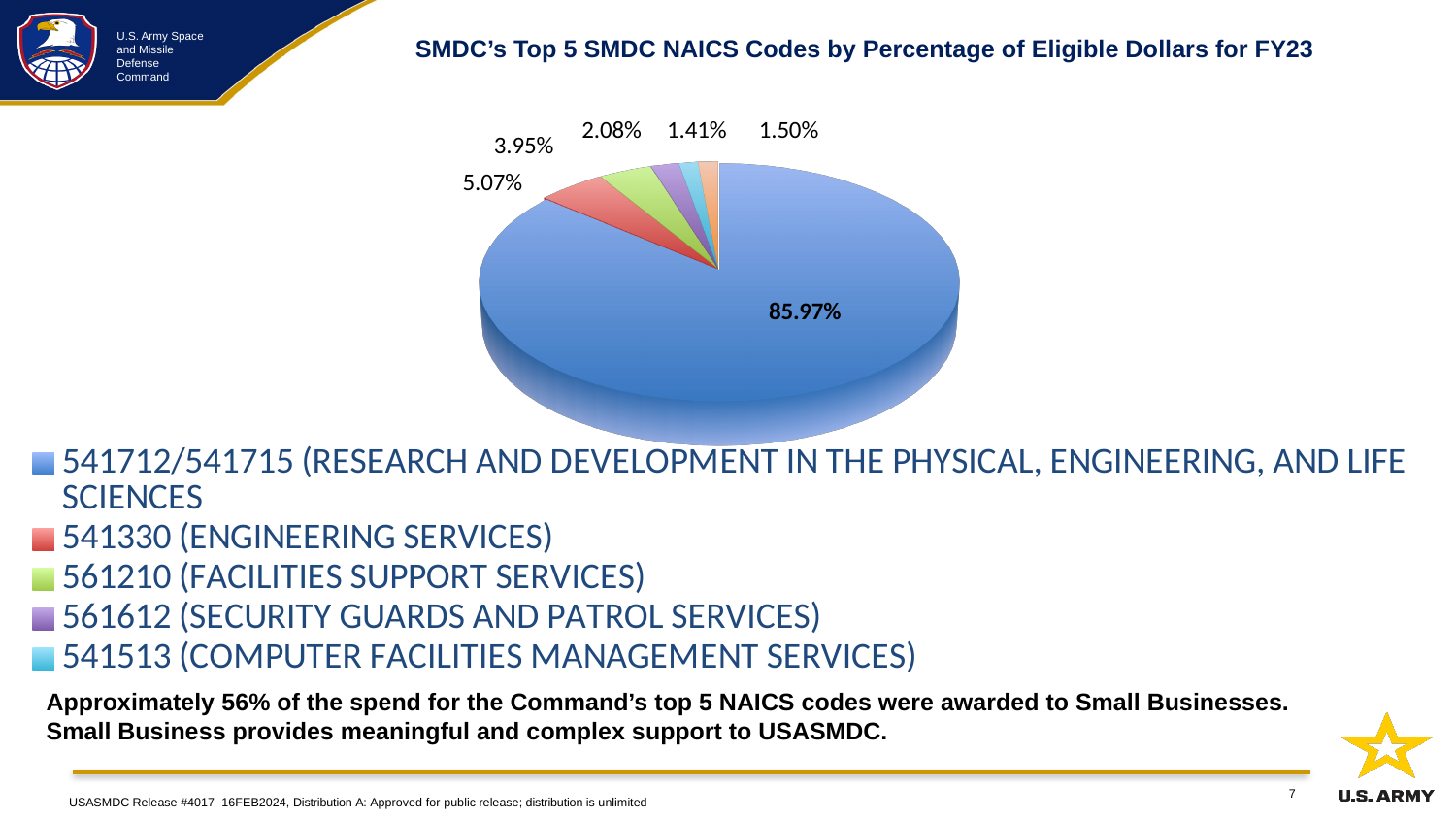
What percentage is shown for 561612 (Security Guards and Patrol Services)? 2.08% Which NAICS code category has the largest share of the pie? 541712/541715 (Research and Development in the Physical, Engineering, and Life Sciences) What is the difference in percentage points between the 541712/541715 slice and the 541330 (Engineering Services) slice? 80.90% What percentage is shown for 561210 (Facilities Support Services)? 3.95% Which of the legend categories has the smallest share of the pie? 541513 (Computer Facilities Management Services) What percentage is shown for 541513 (Computer Facilities Management Services)? 1.41% How many NAICS code categories are listed in the chart legend? 5 What percentage is shown for 541330 (Engineering Services)? 5.07% What type of chart is shown on the slide? Pie chart Which has a larger share: 541330 (Engineering Services) or 561210 (Facilities Support Services)? 541330 (Engineering Services) What is the title of the chart? SMDC's Top 5 SMDC NAICS Codes by Percentage of Eligible Dollars for FY23 What percentage of eligible dollars is shown for 541712/541715 (Research and Development in the Physical, Engineering, and Life Sciences)? 85.97%